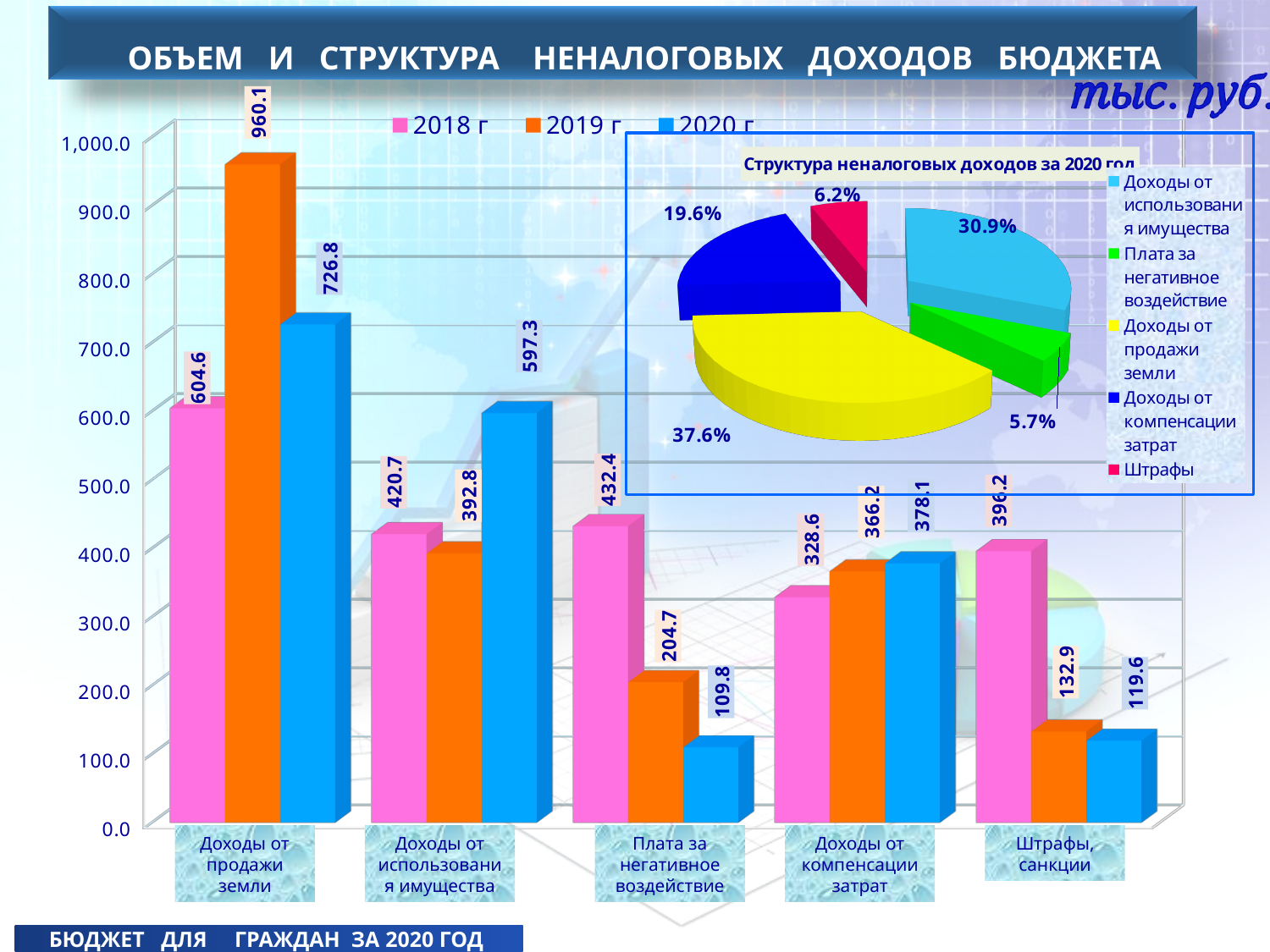
How many series does the bar chart's legend list? 3 On the bar chart, what is the value for Штрафы, санкции in 2018 г? 396.2 On the bar chart, do the values for Плата за негативное воздействие rise or fall from 2018 г to 2020 г? fall On the pie chart Структура неналоговых доходов за 2020 год, what share is Доходы от продажи земли? 37.6% On the bar chart, what is the value for Доходы от продажи земли in 2019 г? 960.1 On the bar chart, which is larger for Доходы от использования имущества: the 2018 г value or the 2020 г value? 2020 г On the bar chart, which category has the highest value in 2020 г? Доходы от продажи земли On the pie chart Структура неналоговых доходов за 2020 год, which slice is the smallest? Плата за негативное воздействие How many categories are shown on the bar chart's x axis? 5 On the bar chart, which category has the lowest value in 2019 г? Штрафы, санкции On the bar chart, what is the difference between the 2019 г and 2018 г values for Доходы от продажи земли? 355.5 On the bar chart, what is the value for Плата за негативное воздействие in 2020 г? 109.8